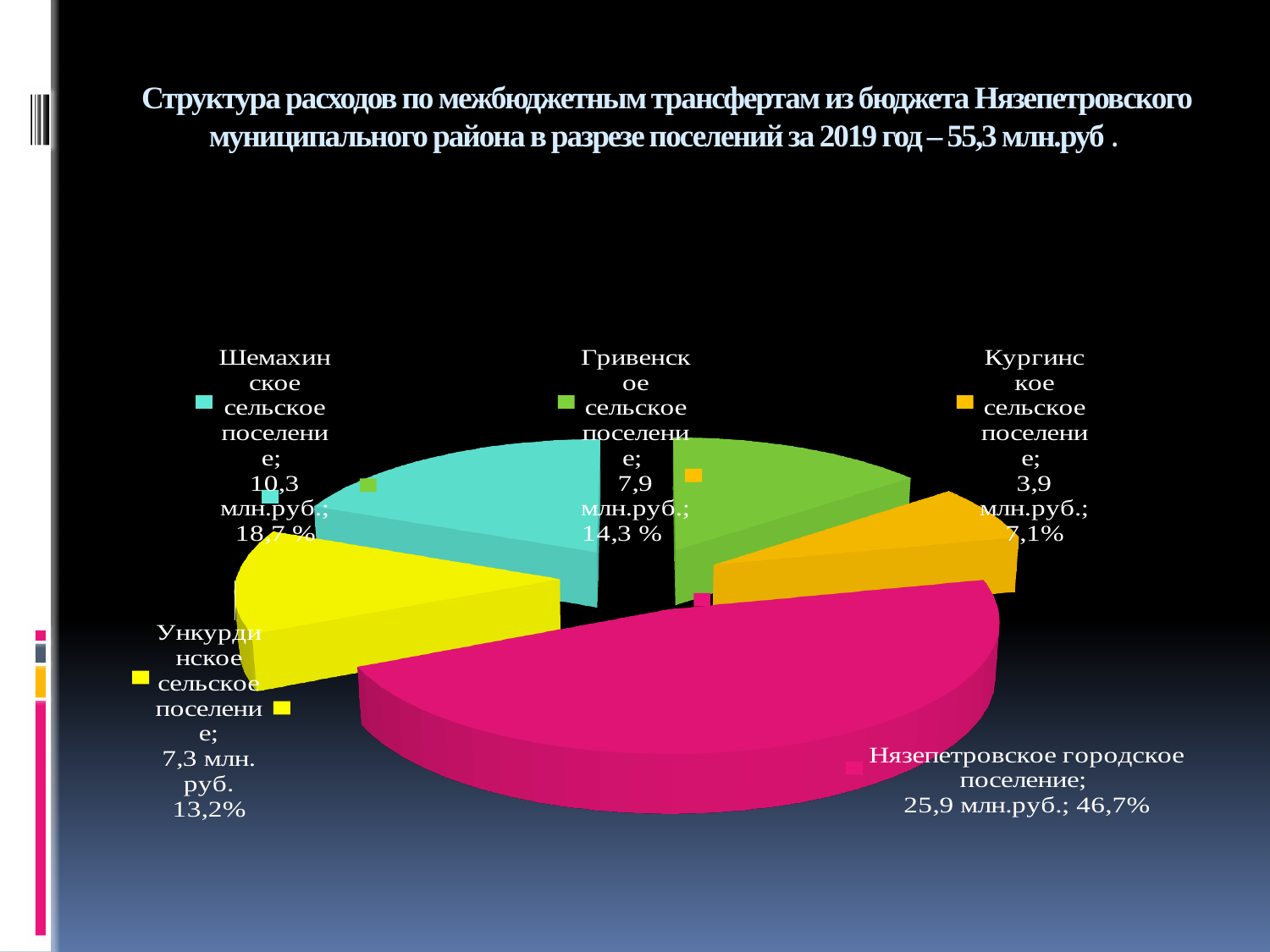
Какова доля Шемахинского сельского поселения в структуре расходов? 18,7 % Сколько поселений (секторов) показано на круговой диаграмме? 5 Какой тип диаграммы показан на слайде? Круговая диаграмма На какое поселение приходится наименьшая доля расходов? Кургинское сельское поселение На какое поселение приходится наибольшая доля расходов? Нязепетровское городское поселение Что больше: расходы по Гривенскому сельскому поселению или по Ункурдинскому сельскому поселению? Гривенское сельское поселение Какой объём расходов приходится на Гривенское сельское поселение? 7,9 млн.руб. Какова общая сумма расходов по межбюджетным трансфертам за 2019 год, указанная в заголовке диаграммы? 55,3 млн.руб. Какой объём расходов приходится на Ункурдинское сельское поселение? 7,3 млн. руб. На сколько млн.руб. расходы по Нязепетровскому городскому поселению больше, чем по Шемахинскому сельскому поселению? 15,6 млн.руб. Какова доля Кургинского сельского поселения в структуре расходов? 7,1% Какой объём расходов приходится на Нязепетровское городское поселение? 25,9 млн.руб.